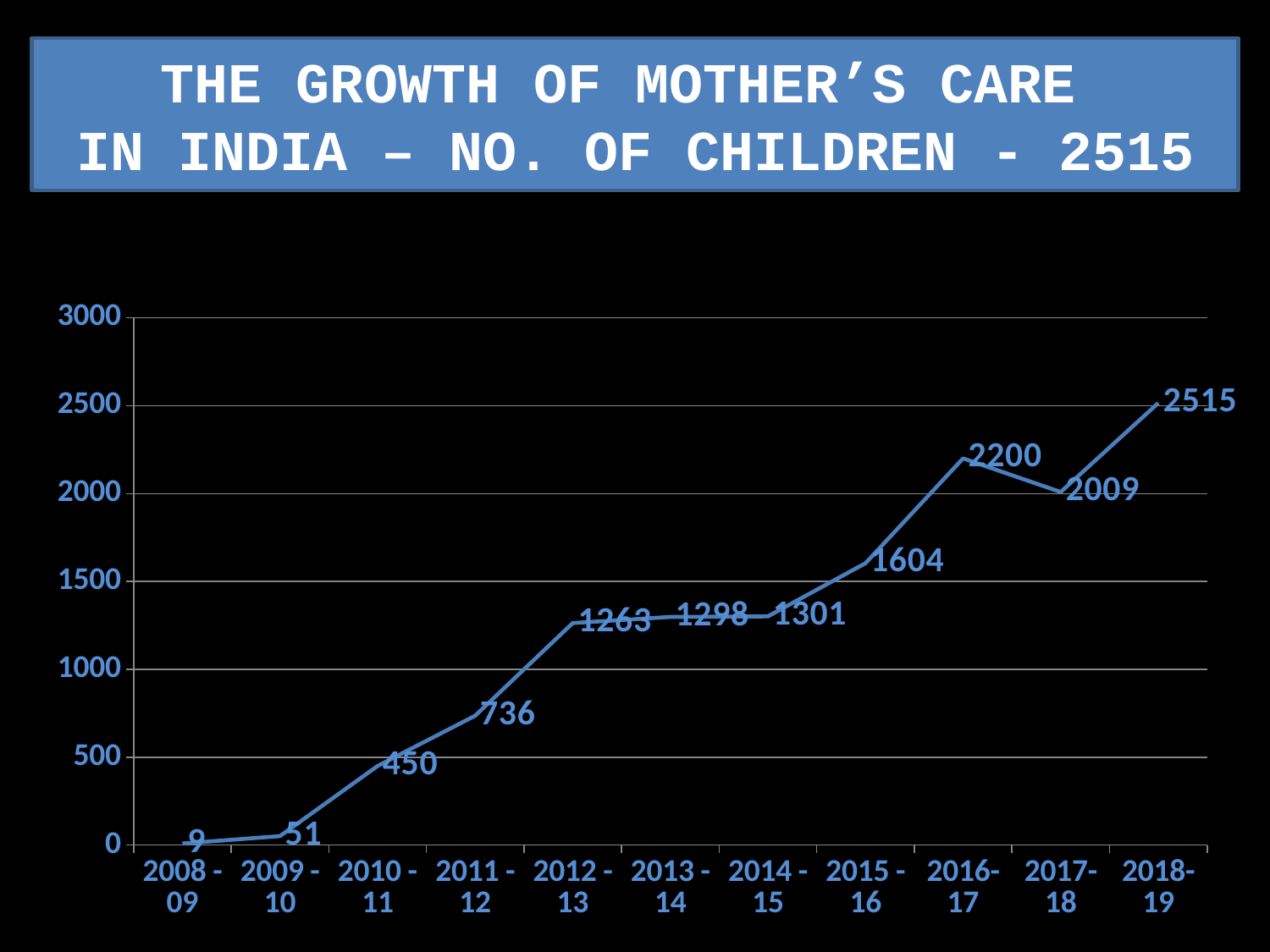
What is the number of children for 2016-17? 2200 What is the number of children for 2012-13? 1263 What is the title of the slide? THE GROWTH OF MOTHER'S CARE IN INDIA – NO. OF CHILDREN - 2515 What type of chart is shown on the slide? line chart What is the number of children for 2008-09? 9 Which is larger, the value for 2016-17 or the value for 2017-18? 2016-17 Which year has the lowest number of children? 2008-09 Is the value for 2015-16 greater or less than 1500? greater What is the difference between the values for 2018-19 and 2017-18? 506 Which year has the highest number of children? 2018-19 How many years are plotted on the x axis? 11 Do the values generally rise or fall from 2008-09 to 2018-19? rise